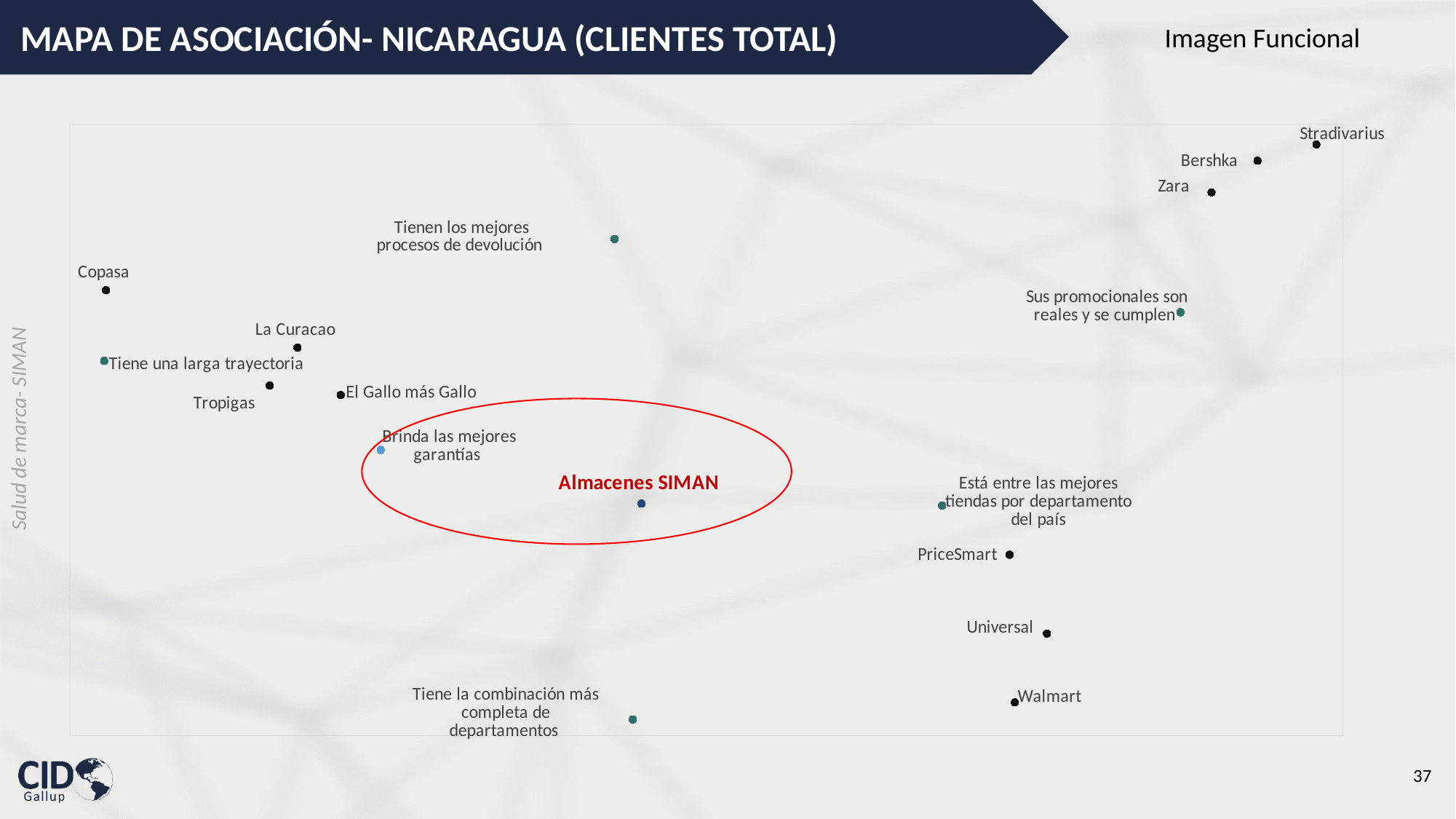
What kind of chart is shown on the slide? Scatter plot (association map) Which three brands are clustered together in the top-right corner of the map? Zara, Bershka, Stradivarius Which brand is plotted furthest to the left on the map? Copasa Which brand is highlighted with a red ellipse on the map? Almacenes SIMAN What is the title of the chart on the slide? MAPA DE ASOCIACIÓN- NICARAGUA (CLIENTES TOTAL) Which brand is plotted highest (topmost) on the map? Stradivarius Which brand is plotted lowest on the map? Walmart Which attribute is plotted closest to Almacenes SIMAN? Tiene la combinación más completa de departamentos Which attribute is plotted closest to Tropigas and La Curacao? Brinda las mejores garantías How many attribute statements are plotted on the association map? 6 Which attribute is plotted closest to PriceSmart? Está entre las mejores tiendas por departamento del país How many brand points are plotted on the association map? 11